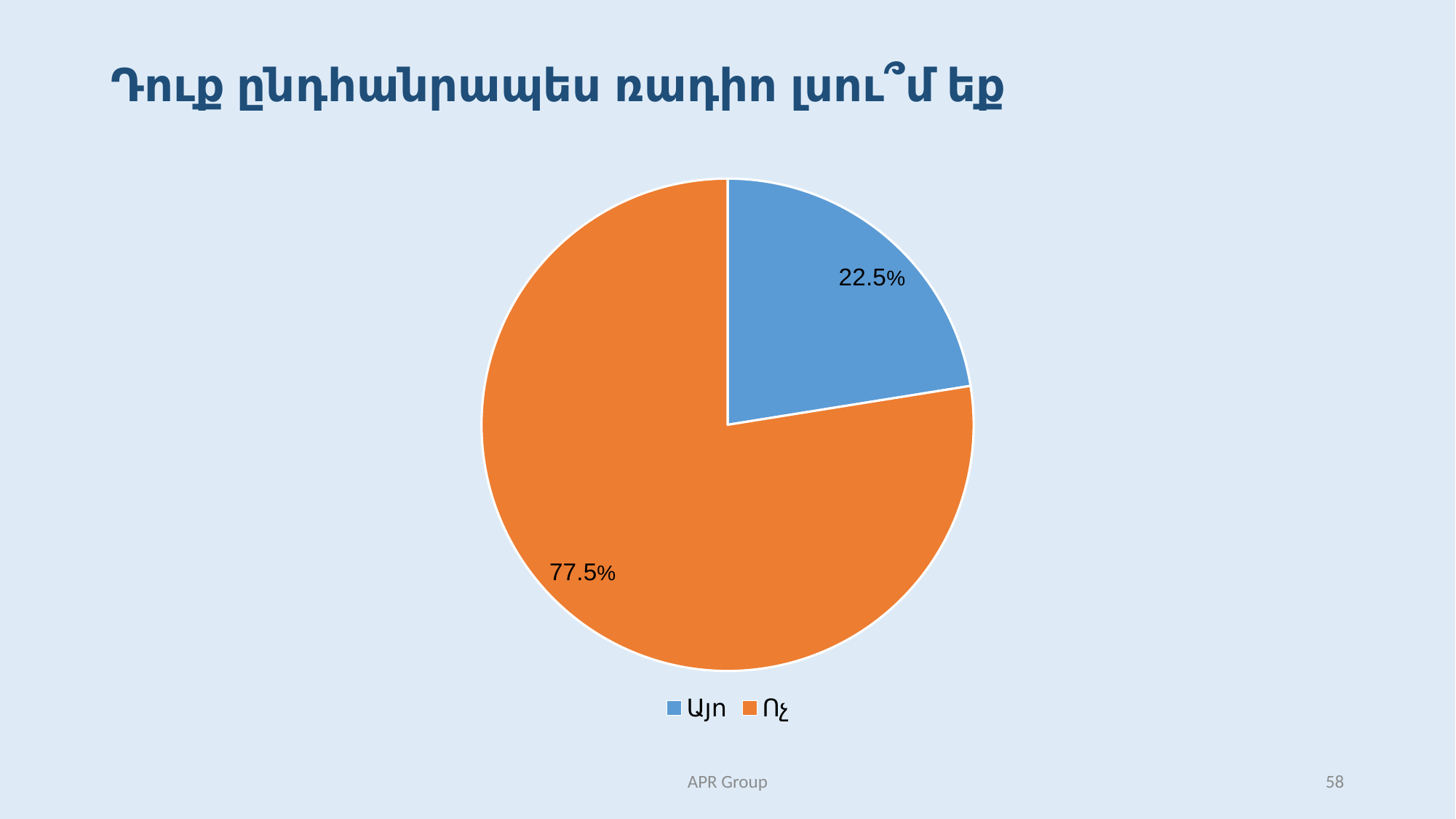
What share of the pie does Այո (Yes) take? 22.5% Is the share for Այո greater or less than 25%? less What share of the pie does Ոչ (No) take? 77.5% Which category has the smallest slice of the pie? Այո What is the difference in percentage points between the Ոչ slice and the Այո slice? 55 percentage points What colour is the Այո slice? blue What kind of chart is shown on the slide? pie chart How many slices does the pie chart have? 2 Which slice is larger, Այո or Ոչ? Ոչ Which category has the largest slice of the pie? Ոչ What colour is the Ոչ slice? orange How many entries does the legend list? 2